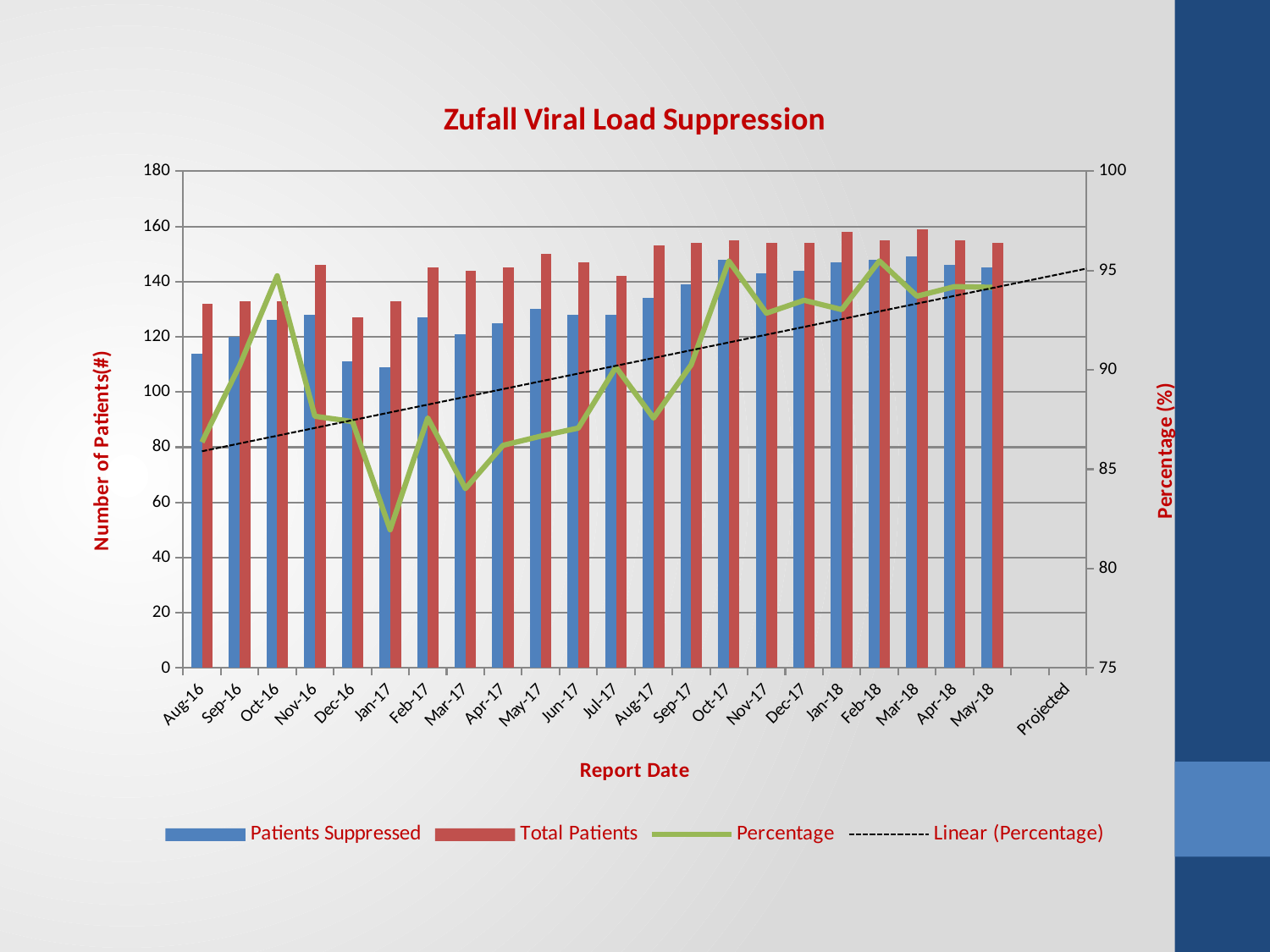
Which report date has the lowest Total Patients value? Dec-16 Which report date has the lowest Percentage value? Jan-17 Is the Patients Suppressed value for Aug-16 greater or less than 120? less How many categories are shown on the x axis (Report Date)? 23 Is the Total Patients value for Aug-16 greater or less than 120? greater What kind of chart is this? Combination bar and line chart Is the Percentage value for Oct-16 greater or less than 90? greater Does the Linear (Percentage) trend line rise or fall from left to right? rise Which is larger, the Total Patients value for Nov-16 or for Dec-16? Nov-16 How many series does the legend list? 4 What is the title of the chart? Zufall Viral Load Suppression